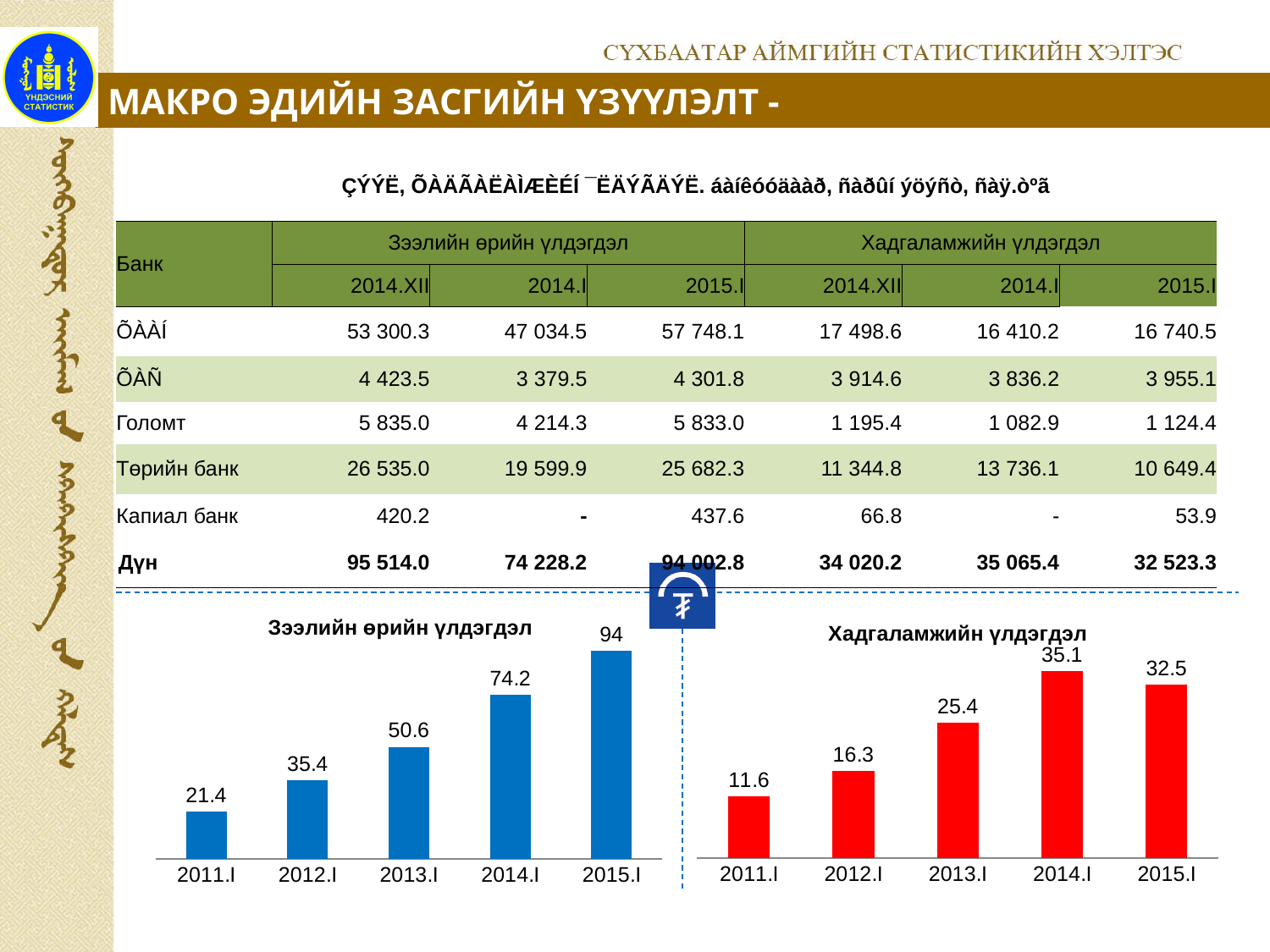
In the chart titled "Зээлийн өрийн үлдэгдэл", what is the difference between the values for 2015.I and 2014.I? 19.8 In the chart titled "Хадгаламжийн үлдэгдэл", what is the value for 2012.I? 16.3 In the chart titled "Зээлийн өрийн үлдэгдэл", do the values rise or fall from 2011.I to 2015.I? Rise What kind of chart is the chart titled "Хадгаламжийн үлдэгдэл"? Bar chart In the chart titled "Хадгаламжийн үлдэгдэл", which year has the highest value? 2014.I In the chart titled "Хадгаламжийн үлдэгдэл", what is the difference between the values for 2014.I and 2015.I? 2.6 In the chart titled "Хадгаламжийн үлдэгдэл", which is larger, the value for 2013.I or the value for 2012.I? 2013.I How many bars are in the chart titled "Зээлийн өрийн үлдэгдэл"? 5 What colour are the bars in the chart titled "Хадгаламжийн үлдэгдэл"? Red In the chart titled "Зээлийн өрийн үлдэгдэл", what is the value for 2015.I? 94 In the chart titled "Зээлийн өрийн үлдэгдэл", what is the value for 2013.I? 50.6 In the chart titled "Зээлийн өрийн үлдэгдэл", which year has the lowest value? 2011.I